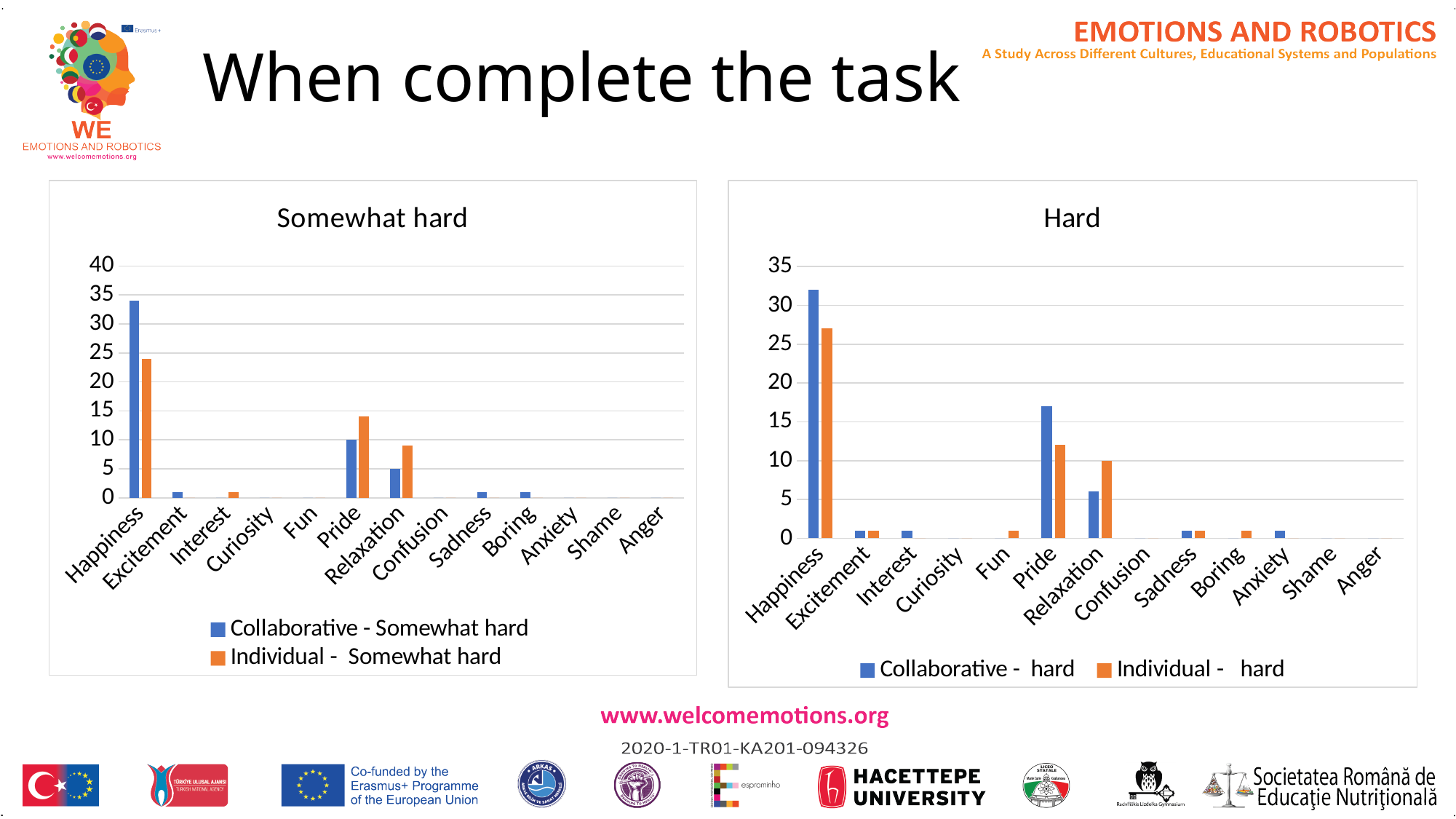
In the 'Hard' chart, is the Collaborative - hard value for Happiness greater or less than 30? greater In the 'Hard' chart, which category has the highest value for Individual - hard? Happiness In the 'Hard' chart, is the Individual - hard value for Pride greater or less than 15? less What kind of chart is the 'Hard' chart? Bar chart In the 'Somewhat hard' chart, which is larger for Pride: Collaborative - Somewhat hard or Individual - Somewhat hard? Individual - Somewhat hard In the 'Somewhat hard' chart, which category has the highest value for Collaborative - Somewhat hard? Happiness In the 'Somewhat hard' chart, is the Individual - Somewhat hard value for Happiness greater or less than 20? greater In the 'Hard' chart, which is larger for Relaxation: Collaborative - hard or Individual - hard? Individual - hard How many series does the legend of the 'Somewhat hard' chart list? 2 How many categories are shown on the x axis of the 'Hard' chart? 13 What is the title of the chart on the left side of the slide? Somewhat hard